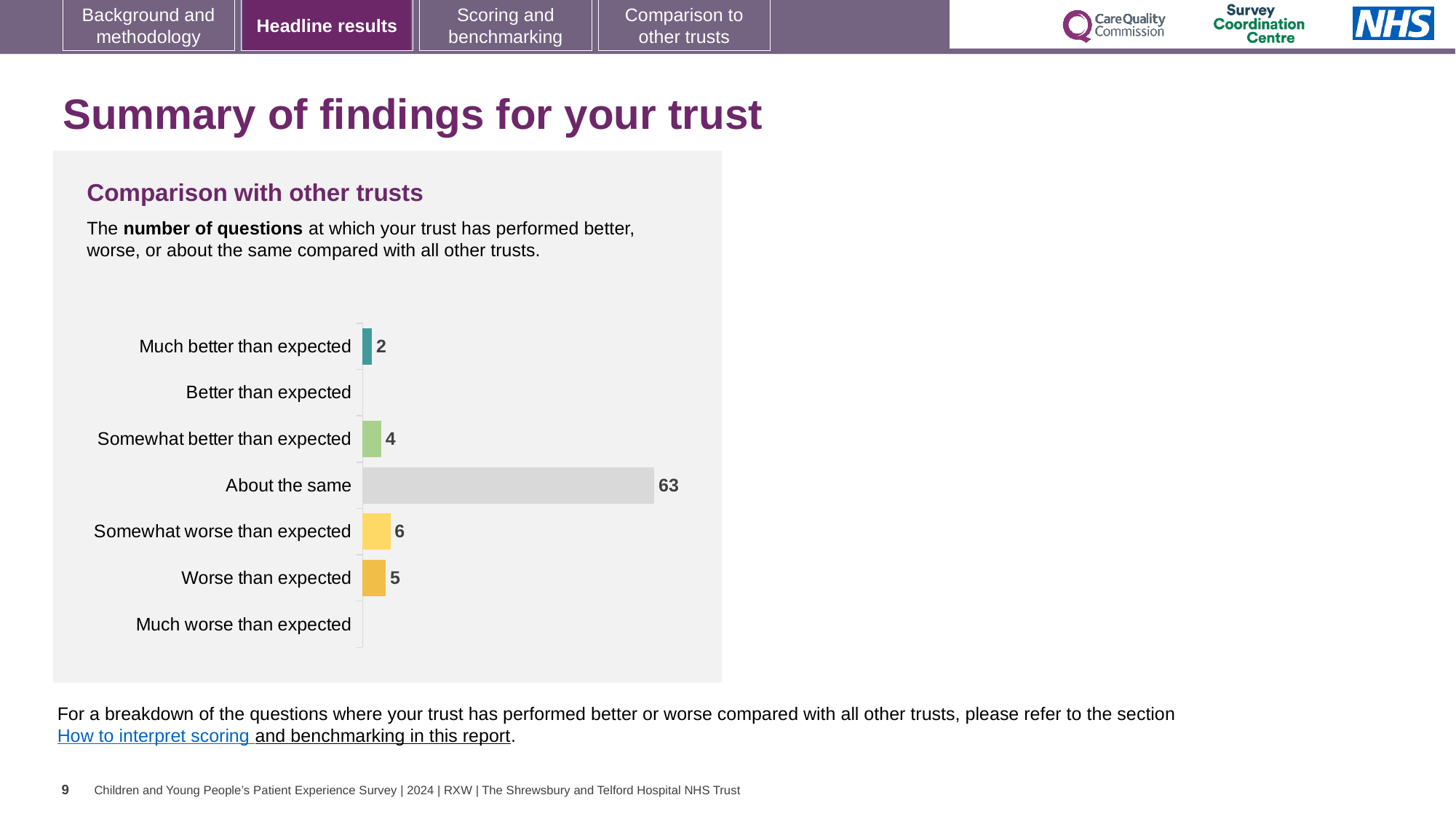
Which is larger: 'Somewhat better than expected' or 'Much better than expected'? Somewhat better than expected Which category has the highest number of questions? About the same What type of chart is shown on the slide? Bar chart How many questions were rated 'About the same'? 63 How many categories are shown on the chart? 7 What is the value for 'Worse than expected'? 5 What is the title of the chart? Comparison with other trusts What is the difference between 'Somewhat better than expected' and 'Much better than expected'? 2 What is the difference between 'About the same' and 'Somewhat worse than expected'? 57 What is the value for 'Somewhat worse than expected'? 6 Which is larger: 'Somewhat worse than expected' or 'Worse than expected'? Somewhat worse than expected What is the value for 'Much better than expected'? 2